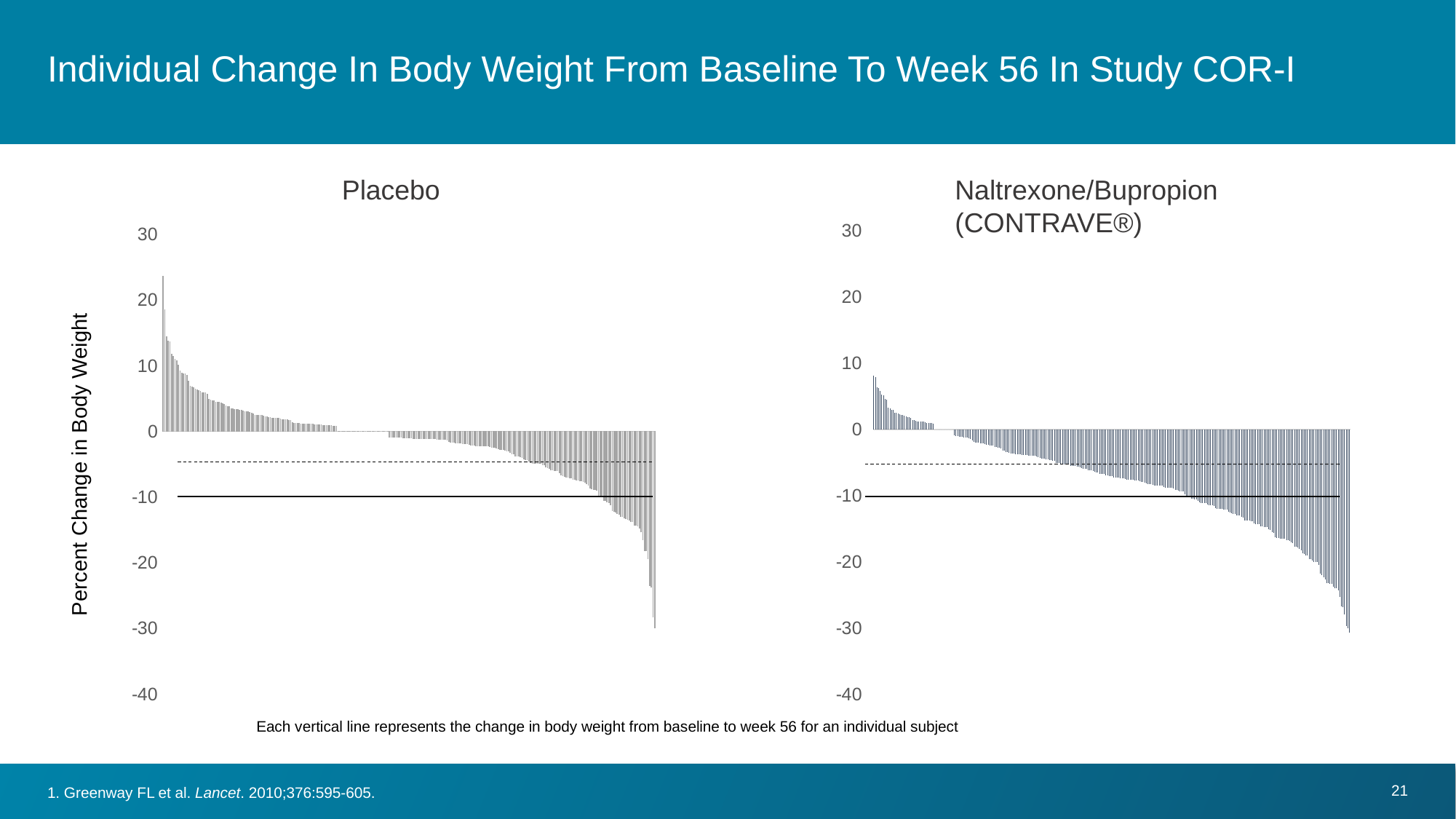
In the Naltrexone/Bupropion (CONTRAVE®) chart, is the lowest bar greater or less than -20? less In the Naltrexone/Bupropion (CONTRAVE®) chart, is the tallest positive bar greater or less than 10? less Which chart shows the larger maximum weight gain, Placebo or Naltrexone/Bupropion (CONTRAVE®)? Placebo What kind of chart is the Naltrexone/Bupropion (CONTRAVE®) chart? bar chart What is the y-axis label shared by the two charts? Percent Change in Body Weight In the Naltrexone/Bupropion (CONTRAVE®) chart, do the bar values rise or fall from left to right? fall What kind of chart is the Placebo chart? bar chart In the Placebo chart, is the tallest positive bar greater or less than 20? greater What is the title of the chart on the right? Naltrexone/Bupropion (CONTRAVE®) What is the lowest value shown on the y-axis of the Placebo chart? -40 In the Placebo chart, do the bar values rise or fall from left to right? fall